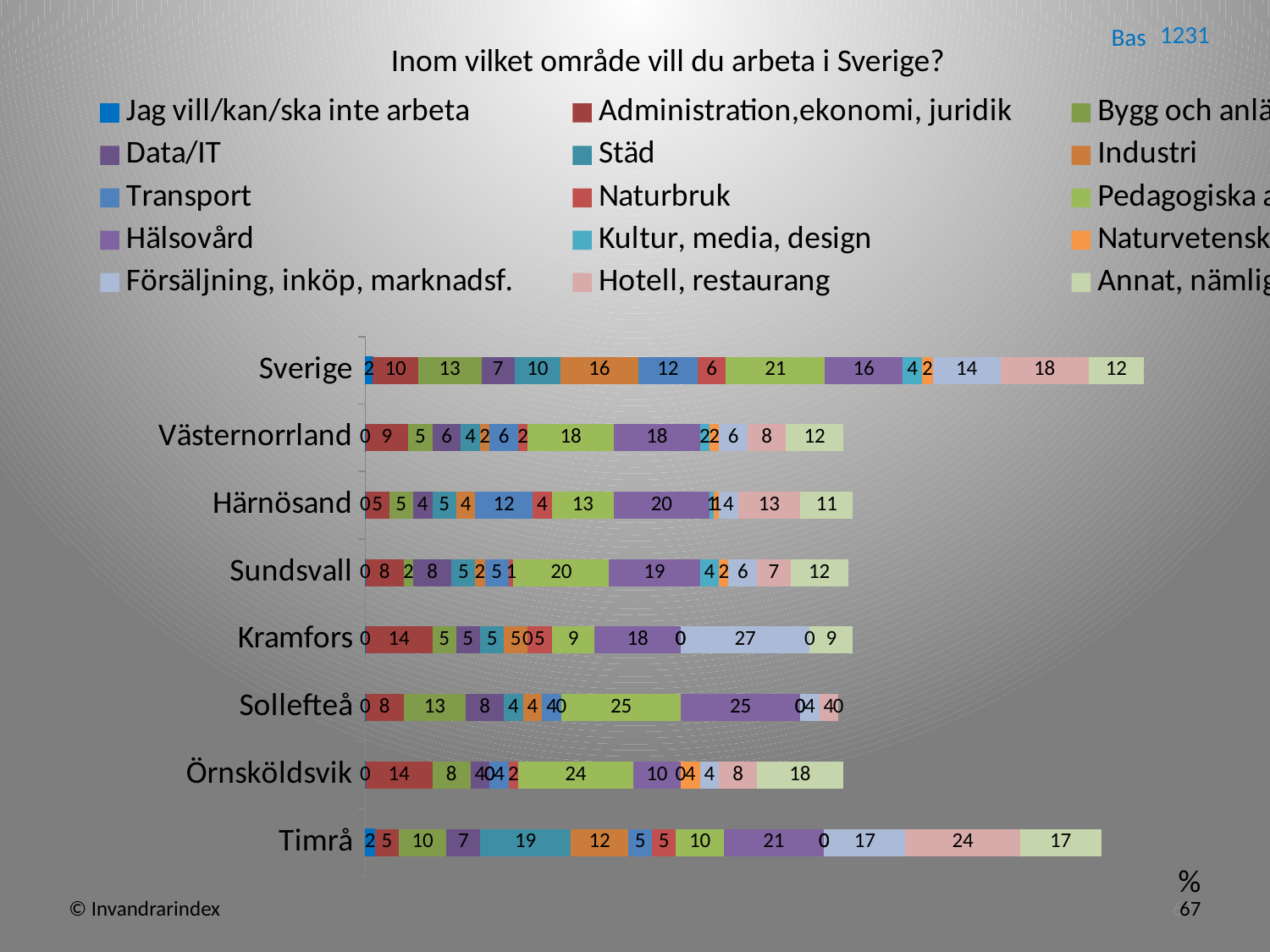
What is the value for Hälsovård in the Härnösand bar? 20 What is the value for Städ in the Timrå bar? 19 What is the value for Hotell, restaurang in the Timrå bar? 24 What kind of chart is shown on the slide? Stacked bar chart What is the difference between the Hotell, restaurang values for Timrå and Sverige? 6 What is the title of the chart? Inom vilket område vill du arbeta i Sverige? What is the value for Hotell, restaurang in the Sverige bar? 18 Which region has the higher Hotell, restaurang value, Timrå or Sverige? Timrå What is the value for Industri in the Sverige bar? 16 What is the value for Försäljning, inköp, marknadsf. in the Kramfors bar? 27 Which region has the highest value for Försäljning, inköp, marknadsf.? Kramfors How many categories (regions) are plotted on the chart? 8